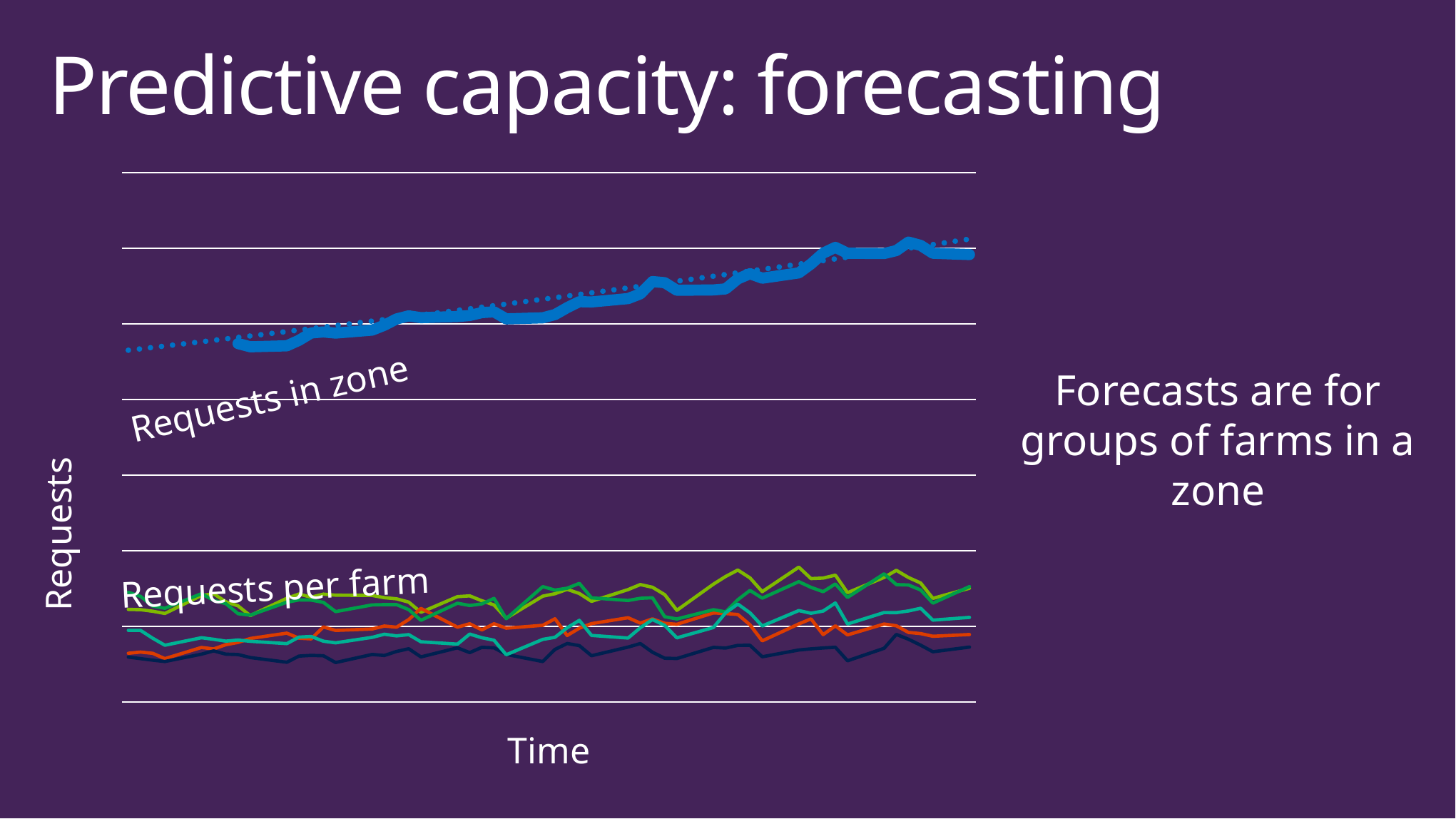
What kind of chart is shown on the slide? line chart Does the "Requests in zone" line rise or fall along the x axis? rise What is the label on the horizontal axis of the chart? Time What is the label on the vertical axis of the chart? Requests Which group of lines sits higher on the chart, "Requests in zone" or "Requests per farm"? Requests in zone